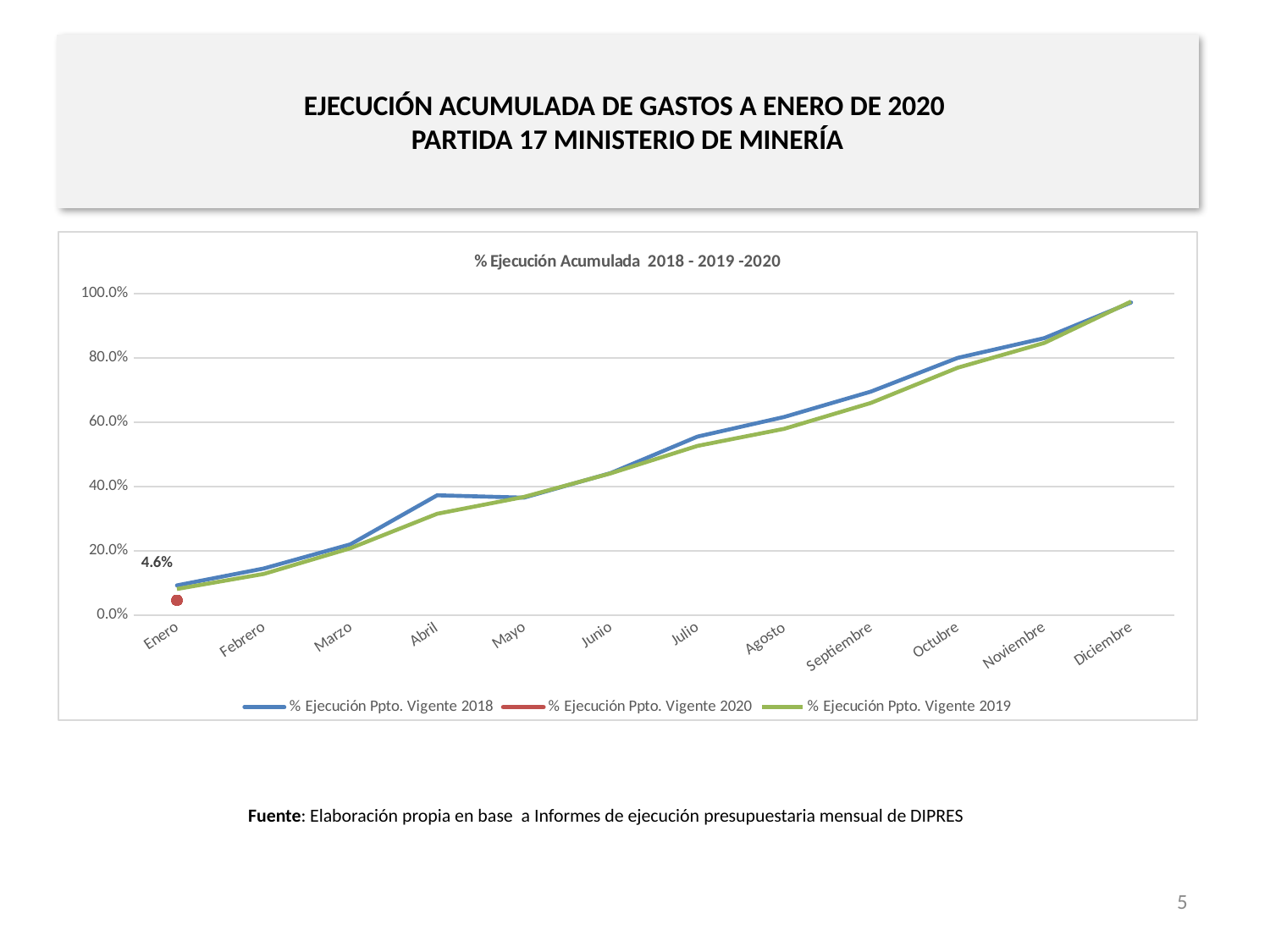
What is the value of % Ejecución Ppto. Vigente 2020 for Enero? 4.6% What kind of chart is shown on the slide? line chart How many months are shown along the x axis of the chart? 12 How many series does the chart legend list? 3 Which month has the lowest value for % Ejecución Ppto. Vigente 2019? Enero Is the value of % Ejecución Ppto. Vigente 2019 for Abril greater or less than 40.0%? less What is the title of the chart? % Ejecución Acumulada 2018 - 2019 -2020 Is the value of % Ejecución Ppto. Vigente 2018 for Diciembre greater or less than 80.0%? greater Is the value of % Ejecución Ppto. Vigente 2019 for Septiembre greater or less than 60.0%? greater In Abril, which series is higher: % Ejecución Ppto. Vigente 2018 or % Ejecución Ppto. Vigente 2019? % Ejecución Ppto. Vigente 2018 Does the % Ejecución Ppto. Vigente 2018 line rise or fall from Enero to Diciembre? rise Which month has the highest value for % Ejecución Ppto. Vigente 2018? Diciembre